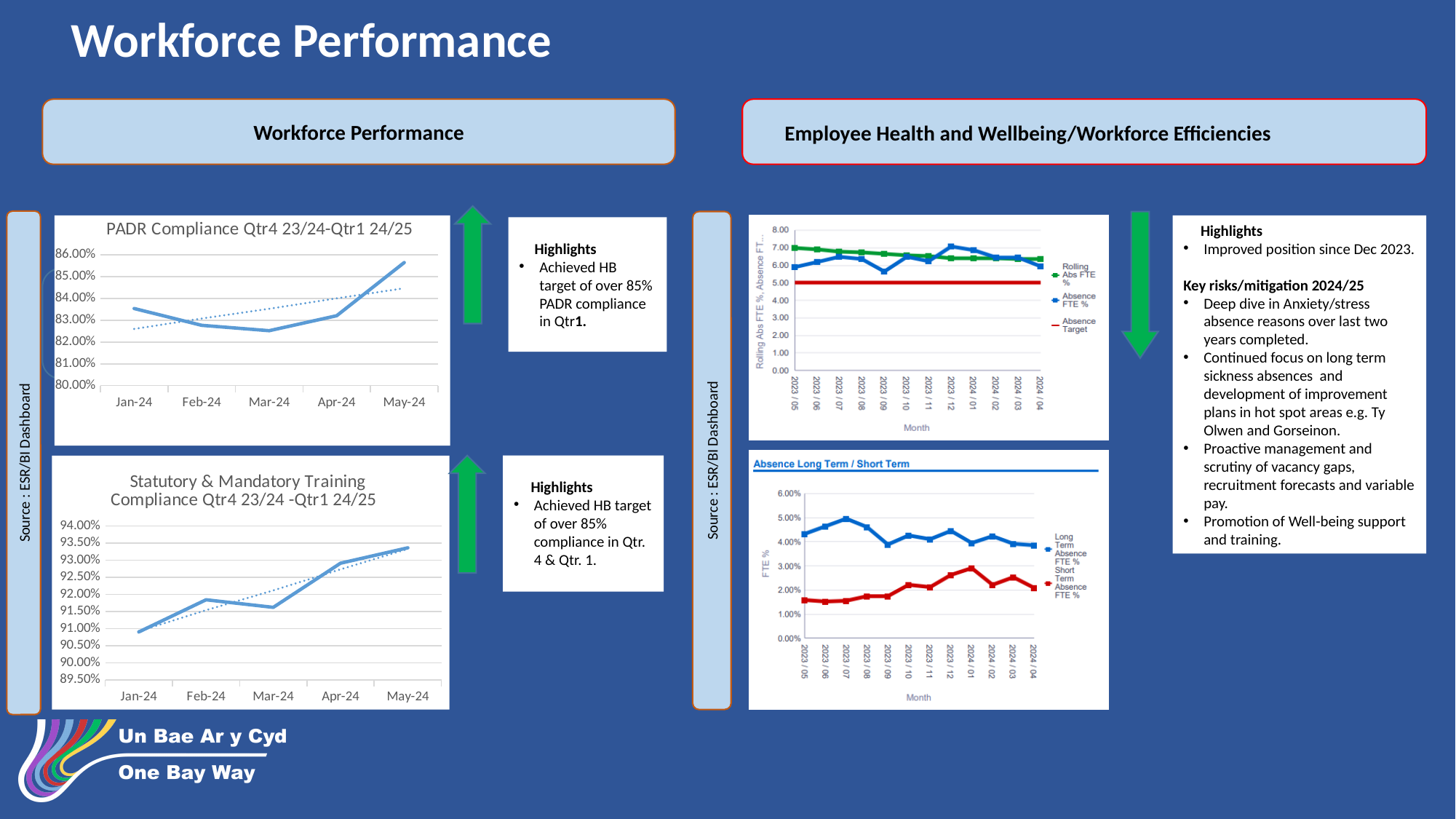
In the 'PADR Compliance Qtr4 23/24-Qtr1 24/25' chart, is the value for Mar-24 greater or less than 83.00%? less In the 'Statutory & Mandatory Training Compliance Qtr4 23/24 -Qtr1 24/25' chart, which month has the lowest value? Jan-24 How many series does the legend list in the top-right absence chart (Rolling Abs FTE %, Absence FTE %, Absence Target)? 3 What kind of chart is the 'PADR Compliance Qtr4 23/24-Qtr1 24/25' chart? Line chart How many months are plotted on the x axis of the 'Statutory & Mandatory Training Compliance Qtr4 23/24 -Qtr1 24/25' chart? 5 In the 'Statutory & Mandatory Training Compliance Qtr4 23/24 -Qtr1 24/25' chart, do the values overall rise or fall from Jan-24 to May-24? Rise In the top-right absence chart, what value is the Absence Target line at? 5.00 In the 'PADR Compliance Qtr4 23/24-Qtr1 24/25' chart, is the value for May-24 greater or less than 85.00%? greater In the 'Absence Long Term / Short Term' chart, which series is larger in 2023 / 07: Long Term Absence FTE % or Short Term Absence FTE %? Long Term Absence FTE % In the 'Statutory & Mandatory Training Compliance Qtr4 23/24 -Qtr1 24/25' chart, is the value for Apr-24 greater or less than 92.50%? greater In the 'PADR Compliance Qtr4 23/24-Qtr1 24/25' chart, which month has the highest compliance value? May-24